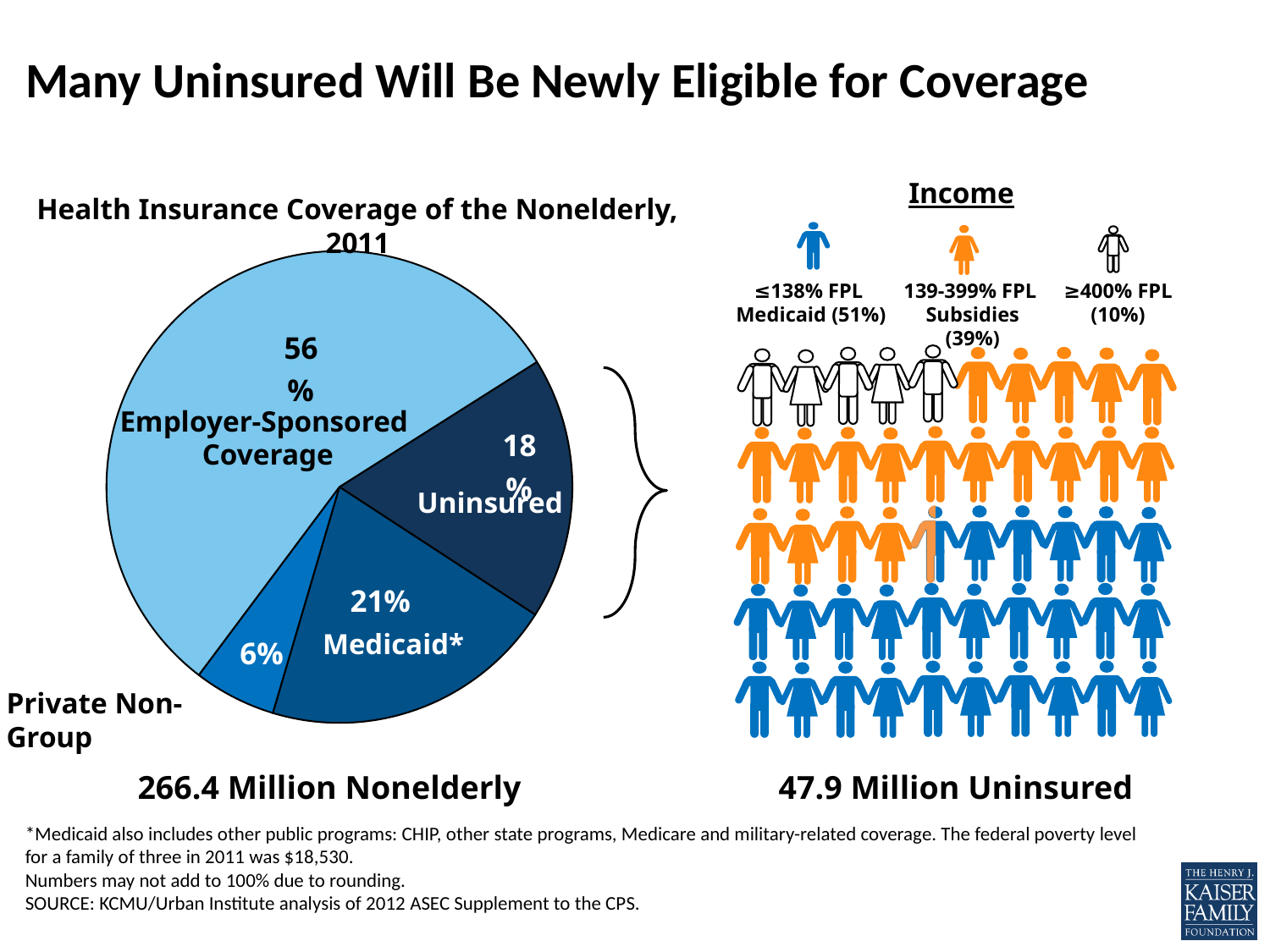
In the pie chart on the left, what is the difference in percentage points between Employer-Sponsored Coverage and Medicaid*? 35 percentage points How many slices does the pie chart on the left have? 4 In the pie chart on the left, which category has the largest slice? Employer-Sponsored Coverage In the pie chart titled 'Health Insurance Coverage of the Nonelderly, 2011', what share is Employer-Sponsored Coverage? 56% In the pictograph on the right, what percentage of the uninsured have income ≥400% FPL? 10% In the pie chart on the left, which category has the smallest slice? Private Non-Group In the pie chart on the left, what percentage of the nonelderly are Uninsured? 18% In the pie chart on the left, what share is Medicaid*? 21% In the pictograph on the right, what percentage of the uninsured have income of 139-399% FPL (Subsidies)? 39% What kind of chart is shown on the left of the slide? Pie chart In the pie chart on the left, which is larger: Medicaid* or Uninsured? Medicaid* In the pie chart on the left, what share is Private Non-Group? 6%